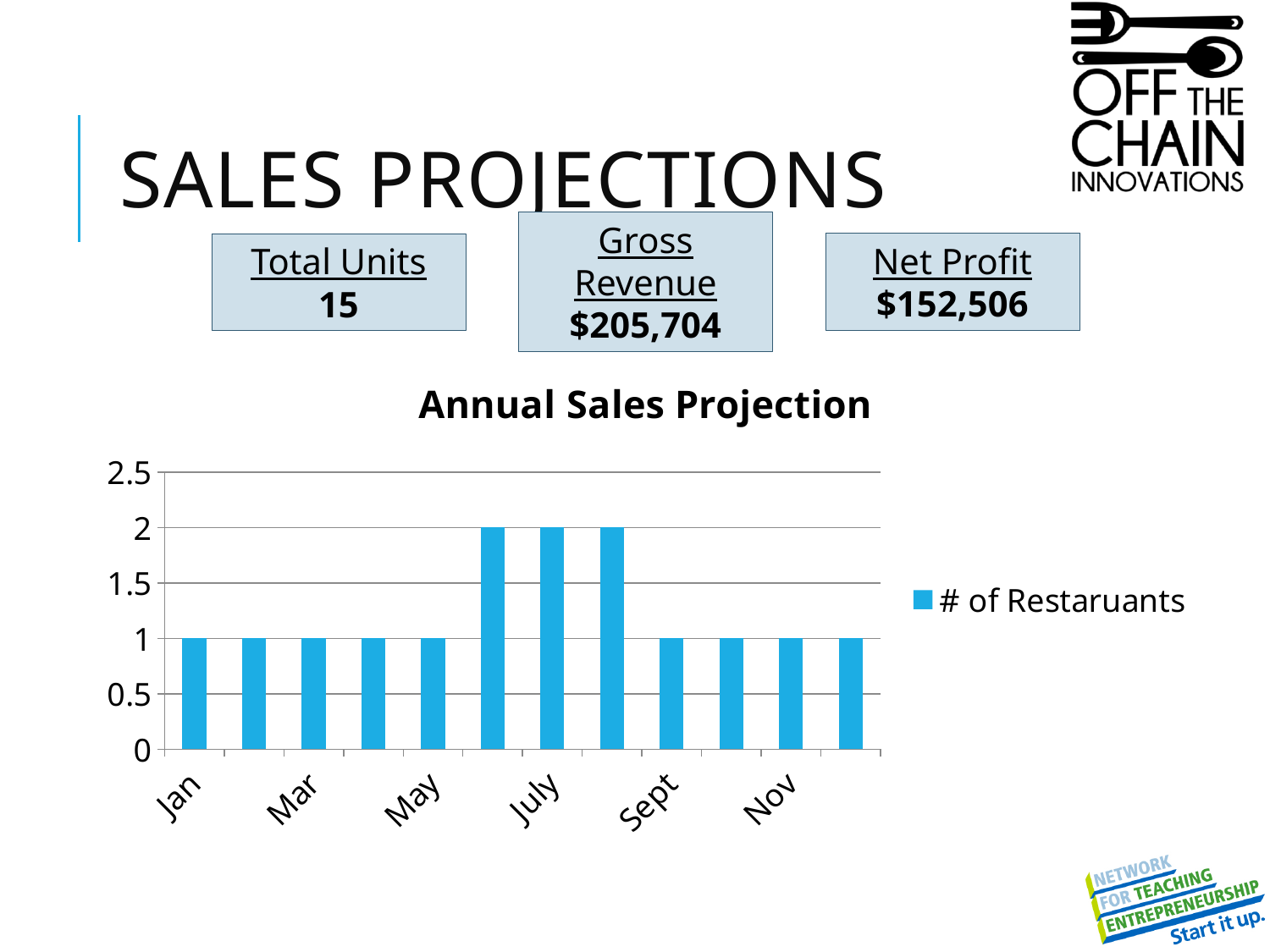
Which is larger in the Annual Sales Projection chart, the value for July or the value for Mar? July What is the difference between the value for July and the value for May in the Annual Sales Projection chart? 1 How many series does the legend of the Annual Sales Projection chart list? 1 How many bars are plotted in the Annual Sales Projection chart? 12 What is the value for July in the Annual Sales Projection chart? 2 How many bars reach a value of 2 in the Annual Sales Projection chart? 3 What kind of chart is the Annual Sales Projection chart? Bar chart What is the highest value reached by any bar in the Annual Sales Projection chart? 2 What is the value for Nov in the Annual Sales Projection chart? 1 What is the value for Jan in the Annual Sales Projection chart? 1 What is the legend entry shown for the Annual Sales Projection chart? # of Restaruants What is the value for Sept in the Annual Sales Projection chart? 1